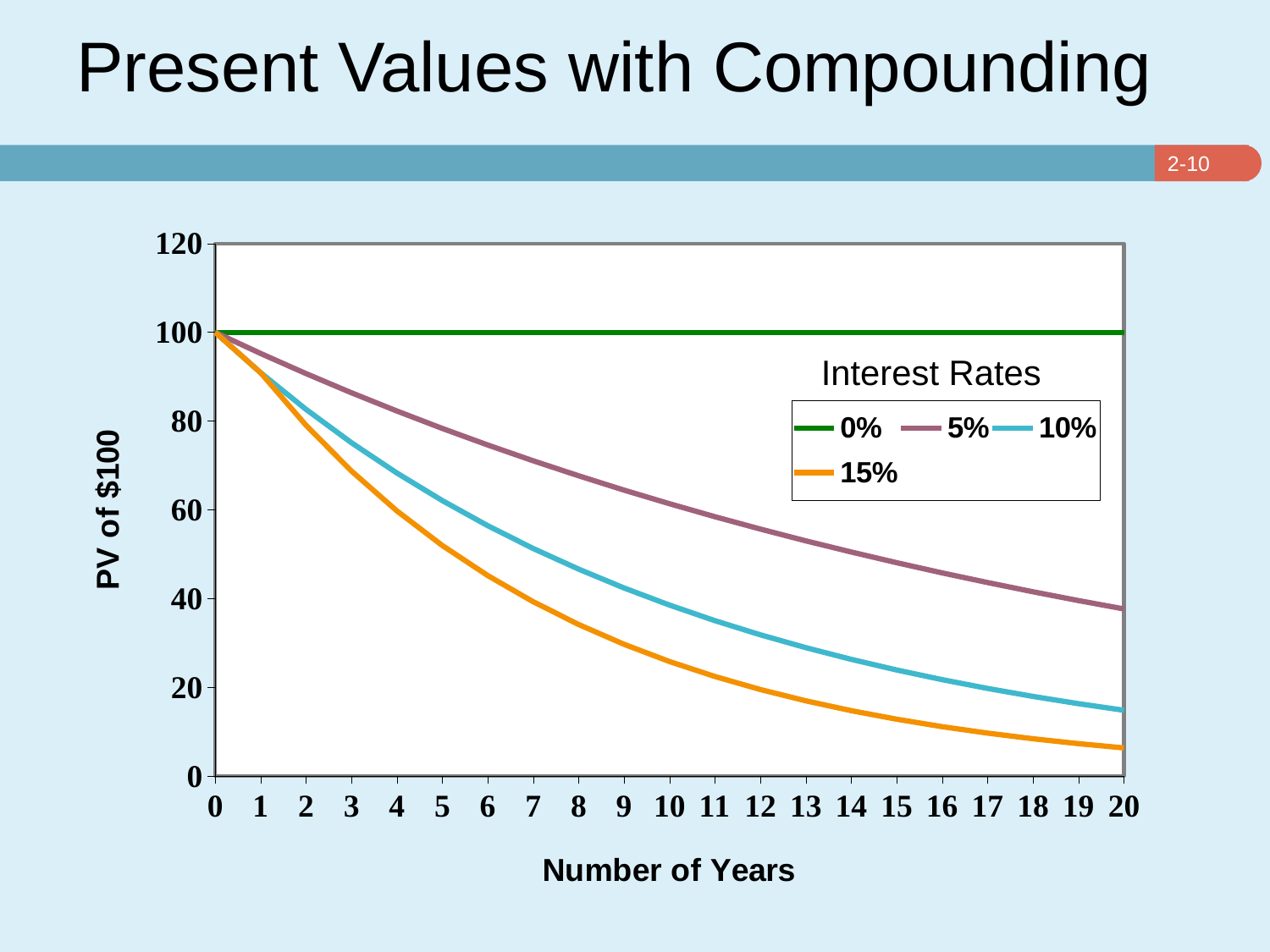
Which interest rate series has the lowest value at year 20? 15% What kind of chart is shown on the slide? line chart What is the title of the legend? Interest Rates Is the value for the 5% series at year 20 greater or less than 40? less What is the PV of $100 for the 0% interest rate at year 20? 100 Which interest rate series has the highest value at year 20? 0% At year 10, which is larger: the value for 5% or the value for 15%? 5% Is the value for the 10% series at year 20 greater or less than 20? less What is the PV of $100 for the 15% interest rate at year 0? 100 How many series does the legend list? 4 Is the value for the 15% series at year 5 greater or less than 60? less Does the 5% series rise or fall as the number of years increases? fall